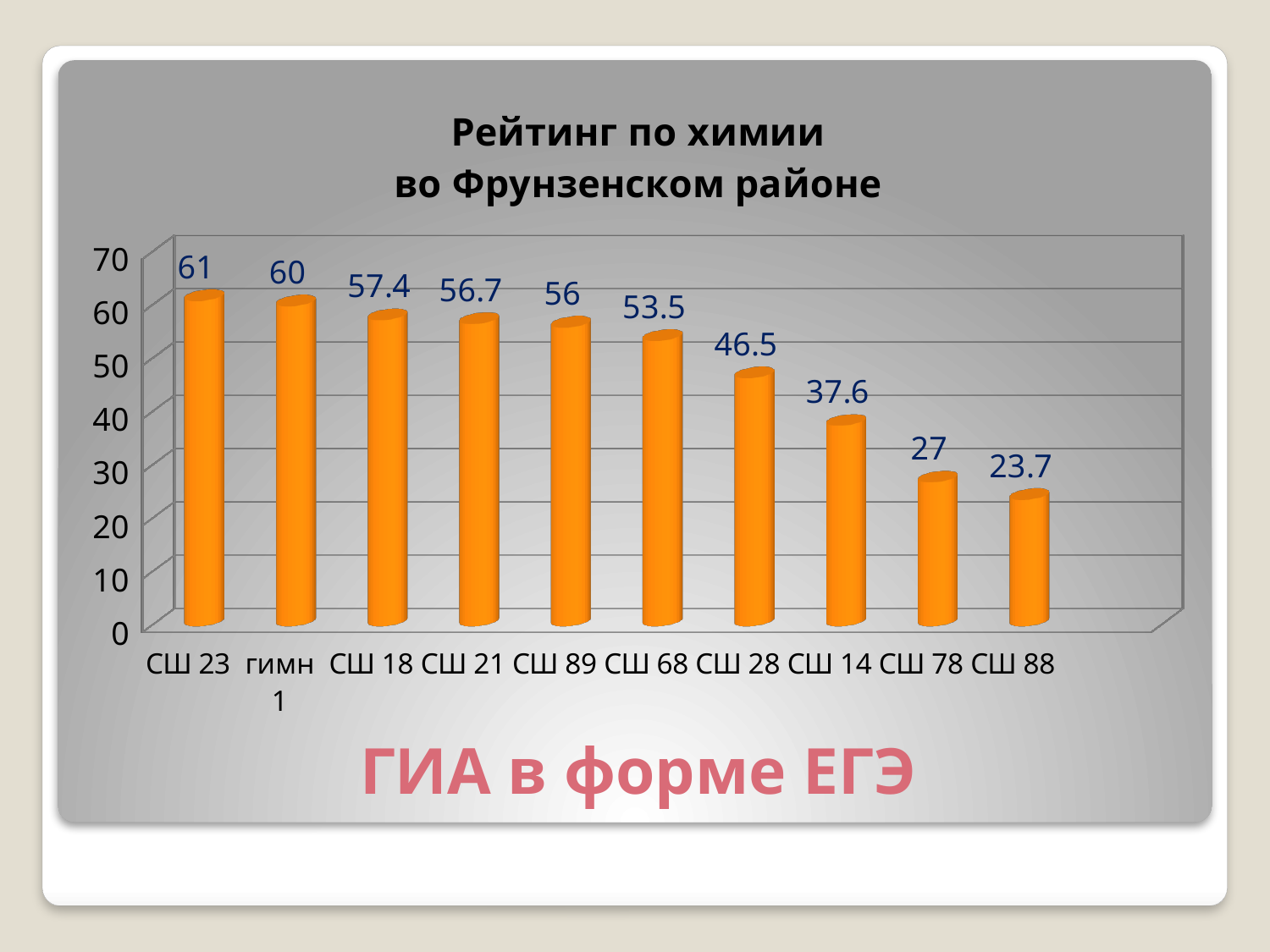
What kind of chart is this? bar chart Which is larger, the value for СШ 14 or the value for СШ 78? СШ 14 What is the difference between the values for СШ 23 and СШ 88? 37.3 What is the difference between the values for СШ 18 and СШ 21? 0.7 How many schools are shown on the chart? 10 What is the value for СШ 88? 23.7 What is the value for СШ 23? 61 Which school has the highest value? СШ 23 Is the value for СШ 68 greater or less than 50? greater What is the value for СШ 28? 46.5 Which school has the lowest value? СШ 88 Do the values rise or fall from left to right along the x axis? fall